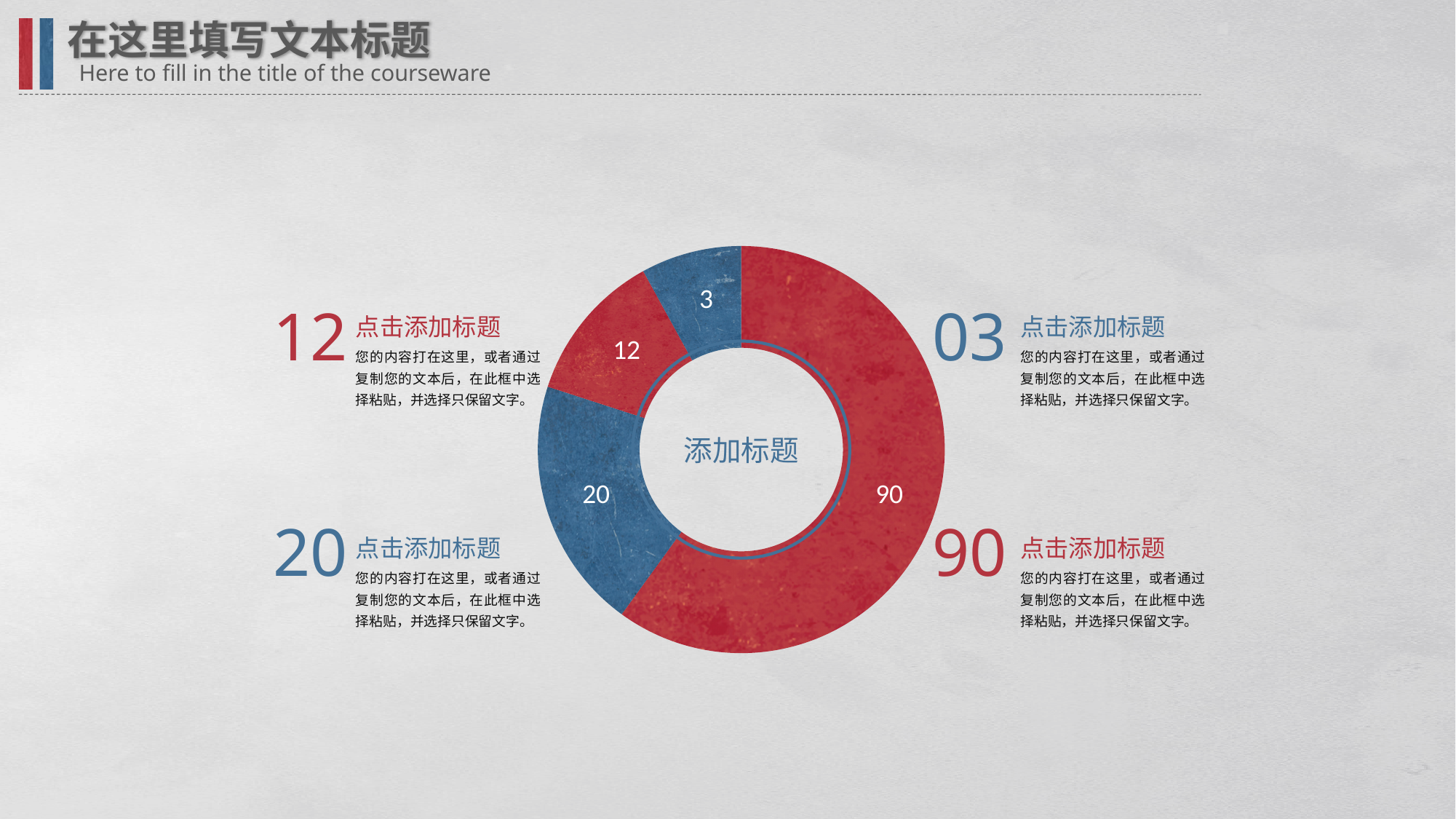
What is the value of the largest slice in the doughnut chart? 90 What kind of chart is shown on the slide? Doughnut chart What text is shown in the centre of the doughnut chart? 添加标题 What is the total of all four slice values in the doughnut chart? 125 What is the difference between the slice labelled 12 and the slice labelled 3? 9 What is the difference between the slice labelled 90 and the slice labelled 20? 70 Which is larger, the slice labelled 12 or the slice labelled 20? 20 How many slices does the doughnut chart have? 4 What is the value shown on the small blue slice at the top of the doughnut chart? 3 What is the value of the smallest slice in the doughnut chart? 3 What is the value shown on the blue slice at the lower left of the doughnut chart? 20